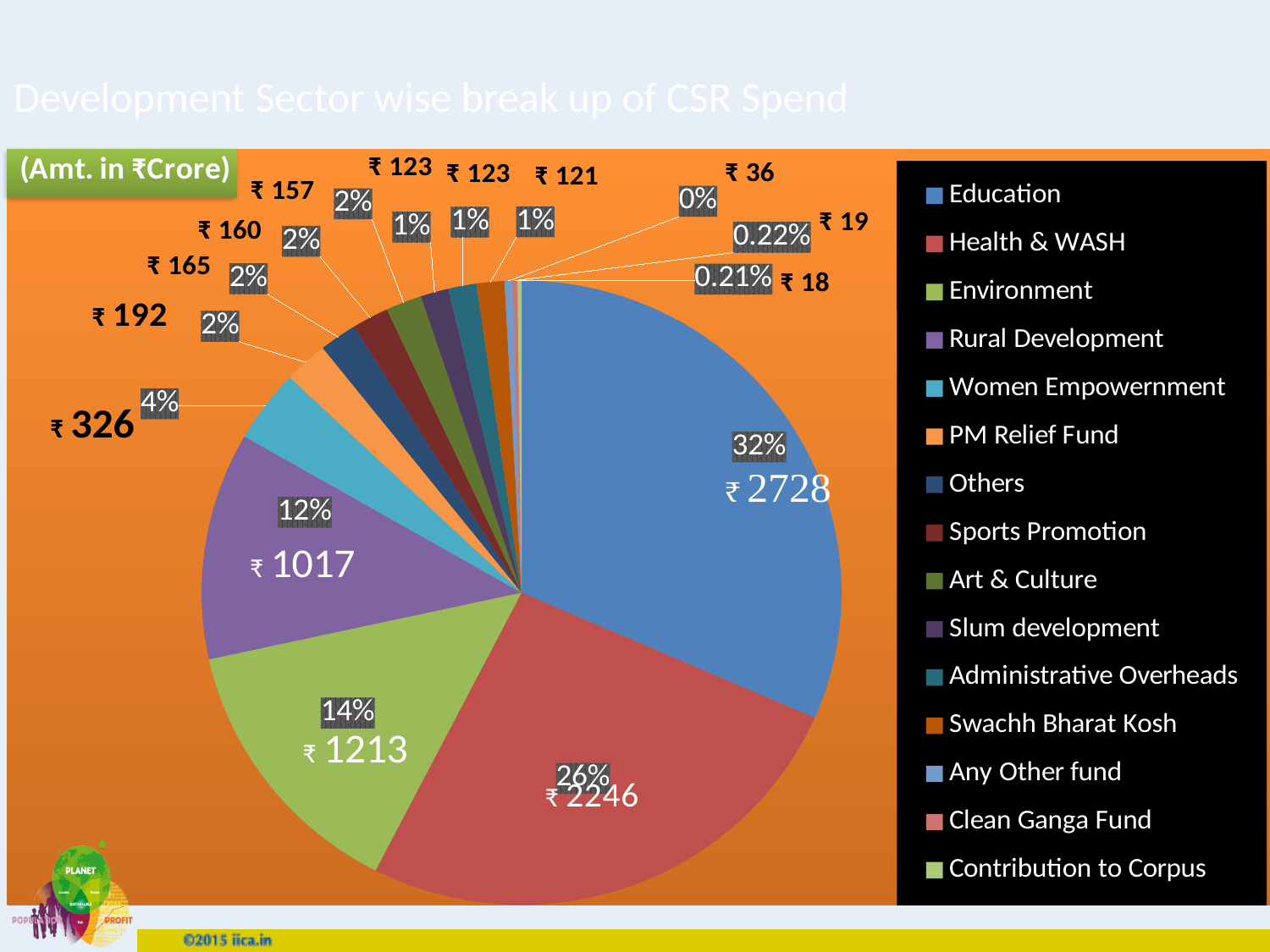
Which is larger, the Environment amount or the Rural Development amount? Environment What is the title of the chart? Development Sector wise break up of CSR Spend In what unit are the amounts on the chart expressed? ₹ Crore What is the CSR spend amount for Education? ₹ 2728 What is the CSR spend amount for Women Empowernment? ₹ 326 What percentage share does Health & WASH have? 26% What kind of chart is shown on the slide? Pie chart How many categories does the legend list? 15 Which sector has the largest share of CSR spend? Education What is the difference between the Education and Health & WASH amounts? ₹ 482 What is the CSR spend amount for Environment? ₹ 1213 What percentage share does Rural Development have? 12%